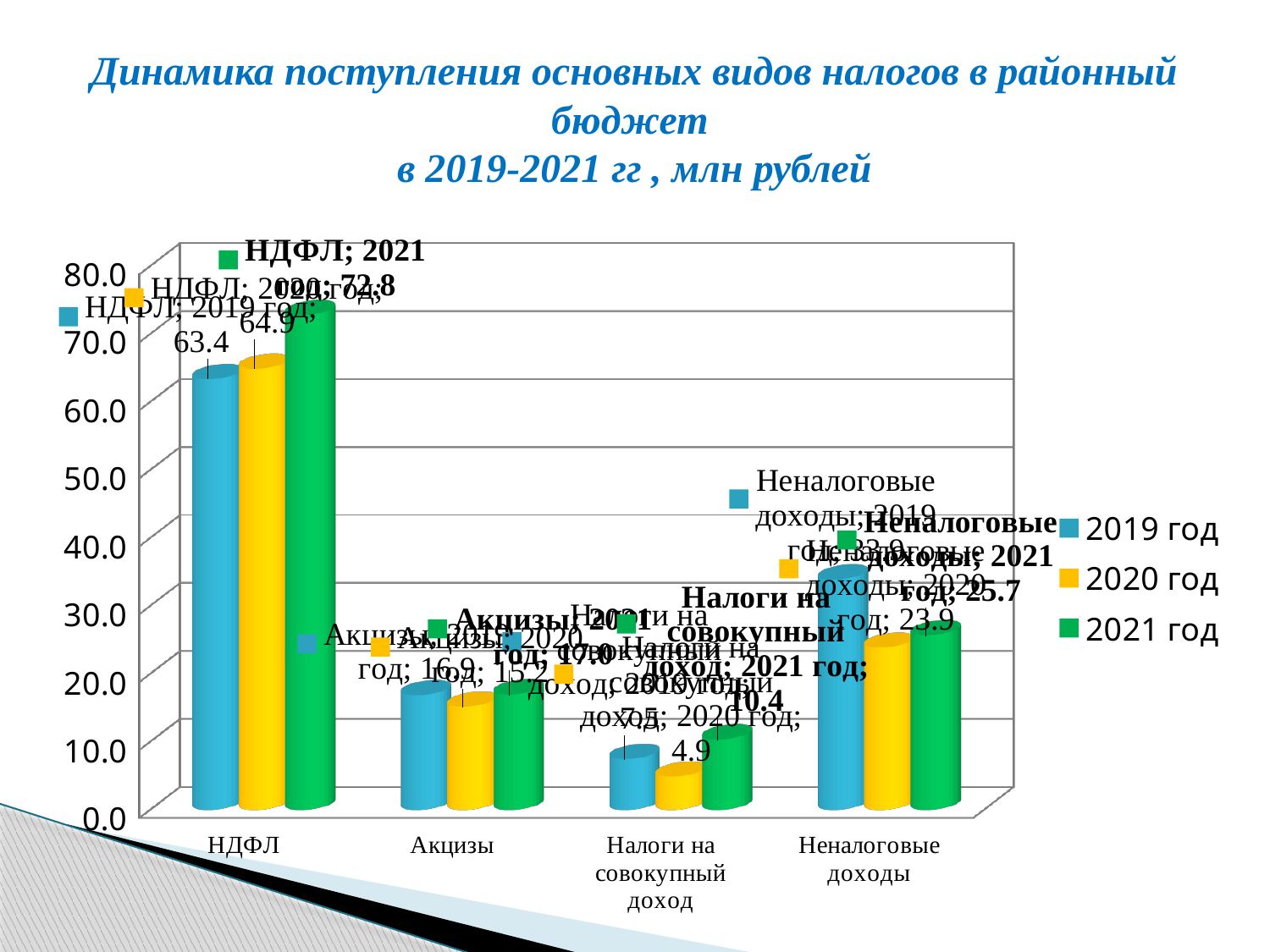
What is the difference between the НДФЛ values for 2021 год and 2019 год? 9.4 What kind of chart is shown on the slide? bar chart Which category has the highest value for 2021 год? НДФЛ What is the value for Налоги на совокупный доход in 2020 год? 4.9 Which category has the lowest value for 2020 год? Налоги на совокупный доход What is the value for НДФЛ in 2019 год? 63.4 What is the value for Неналоговые доходы in 2021 год? 25.7 Is the value for Неналоговые доходы in 2019 год greater or less than 30.0? greater How many categories are shown on the x axis? 4 How many series does the legend list? 3 For Неналоговые доходы, which is larger: the 2020 год value or the 2021 год value? 2021 год What is the value for НДФЛ in 2021 год? 72.8